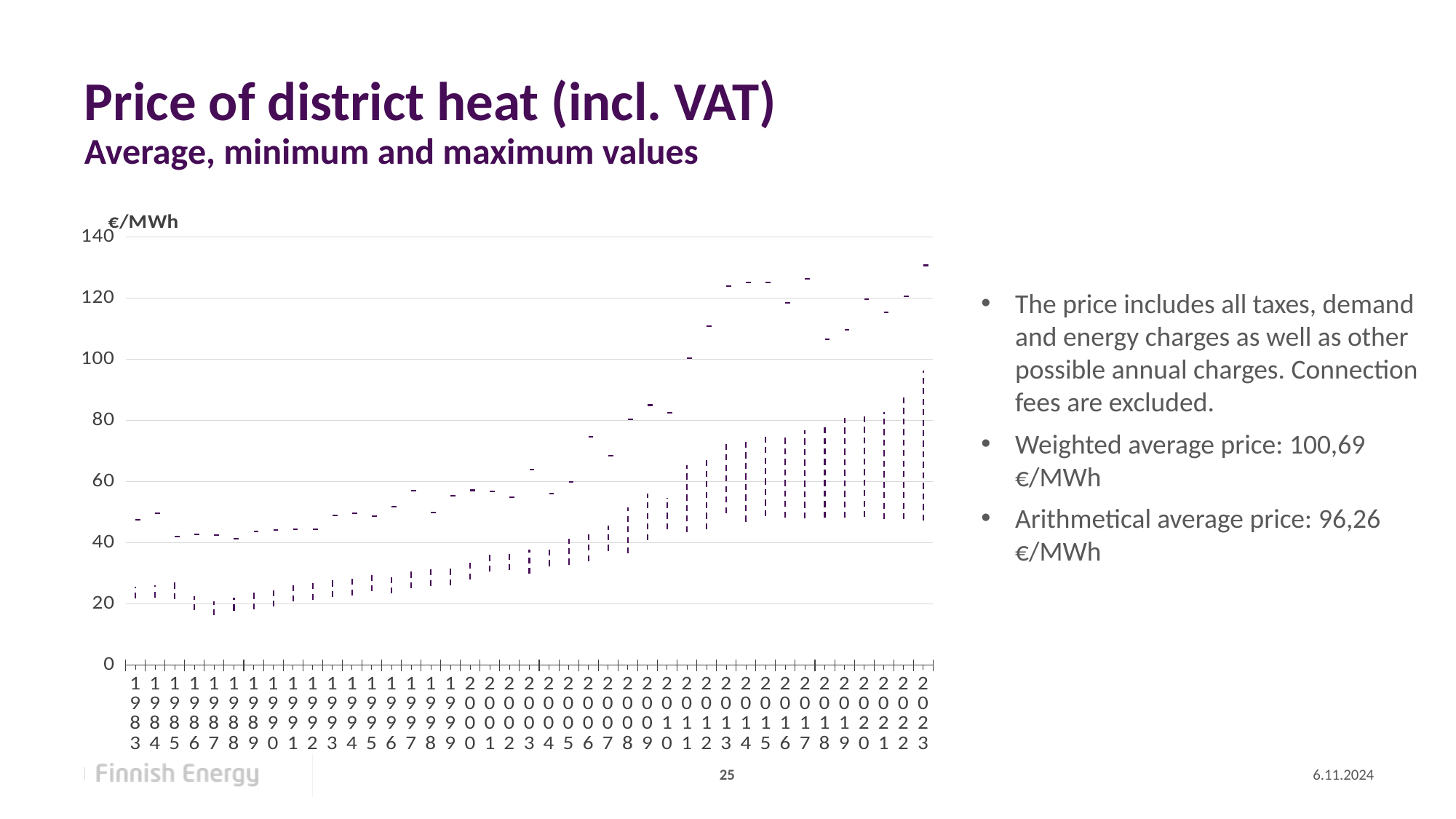
What is the last year shown on the horizontal axis of the chart? 2023 What unit is shown on the vertical axis of the chart? €/MWh How many years are plotted along the horizontal axis of the chart? 41 What is the first year shown on the horizontal axis of the chart? 1983 Is the minimum price value for 1986 greater or less than 20 €/MWh? less Do the district heat prices generally rise or fall from 1983 to 2023 in the chart? rise What is the title of the chart on the slide? Price of district heat (incl. VAT) Is the maximum price value for 1983 greater or less than 60 €/MWh? less What is the highest value shown on the vertical axis of the chart? 140 Is the maximum price value for 2023 greater or less than 120 €/MWh? greater Which year has the higher maximum price value in the chart, 1990 or 2020? 2020